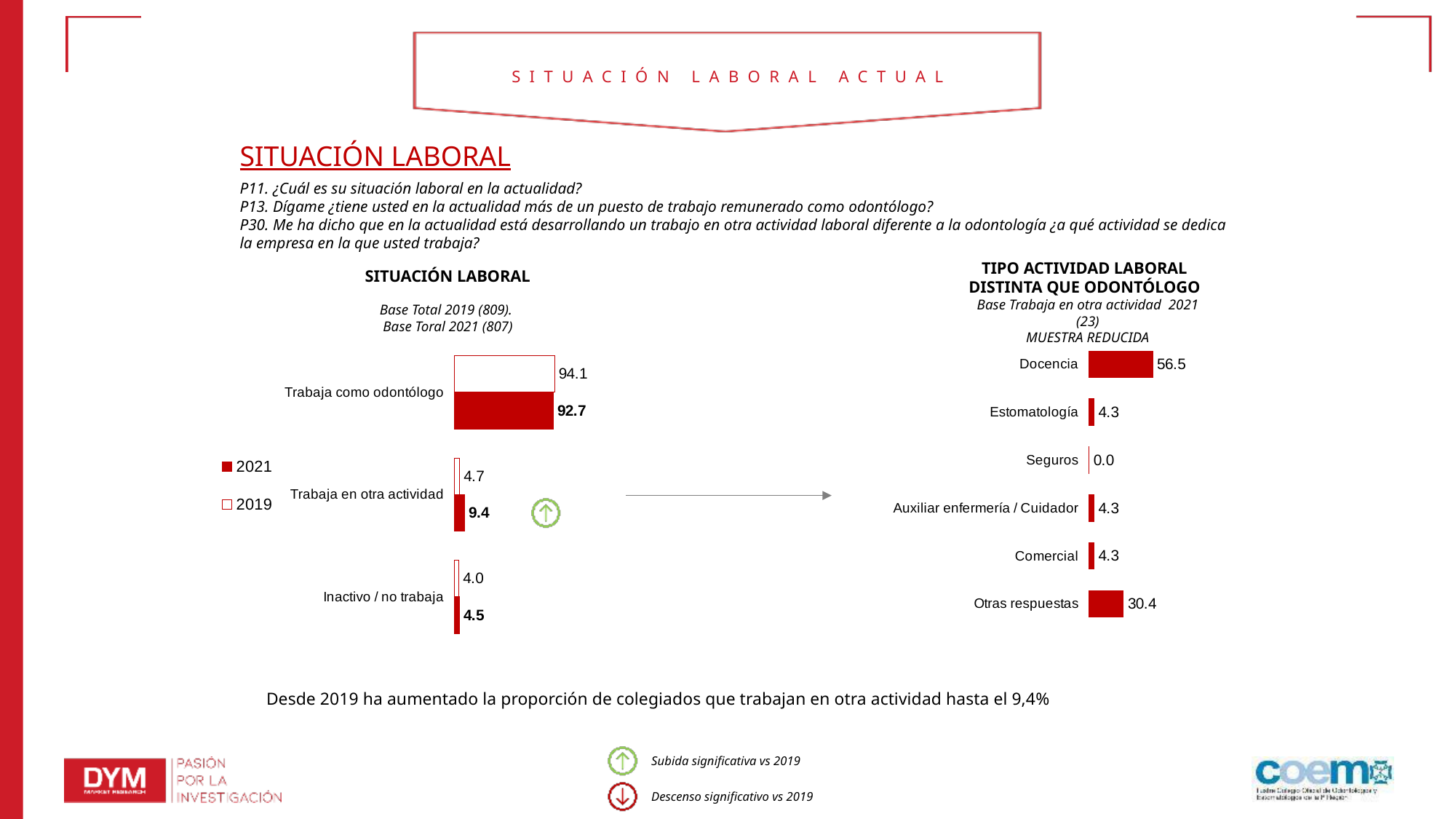
In the 'SITUACIÓN LABORAL' chart, is the 2021 value for 'Trabaja en otra actividad' larger or smaller than the 2019 value? larger In the 'SITUACIÓN LABORAL' chart, which category has the highest 2021 value? Trabaja como odontólogo In the 'SITUACIÓN LABORAL' chart, what is the 2019 value for 'Trabaja en otra actividad'? 4.7 In the 'SITUACIÓN LABORAL' chart, how many series does the legend list? 2 In the 'TIPO ACTIVIDAD LABORAL DISTINTA QUE ODONTÓLOGO' chart, how many categories are shown? 6 In the 'SITUACIÓN LABORAL' chart, what is the difference between the 2019 and 2021 values for 'Trabaja como odontólogo'? 1.4 In the 'TIPO ACTIVIDAD LABORAL DISTINTA QUE ODONTÓLOGO' chart, what is the value for 'Docencia'? 56.5 In the 'TIPO ACTIVIDAD LABORAL DISTINTA QUE ODONTÓLOGO' chart, which category has the lowest value? Seguros In the 'SITUACIÓN LABORAL' chart, what is the 2021 value for 'Trabaja como odontólogo'? 92.7 In the 'TIPO ACTIVIDAD LABORAL DISTINTA QUE ODONTÓLOGO' chart, what is the difference between 'Docencia' and 'Otras respuestas'? 26.1 In the 'SITUACIÓN LABORAL' chart, what is the 2021 value for 'Inactivo / no trabaja'? 4.5 What kind of chart is the 'TIPO ACTIVIDAD LABORAL DISTINTA QUE ODONTÓLOGO' chart? Bar chart